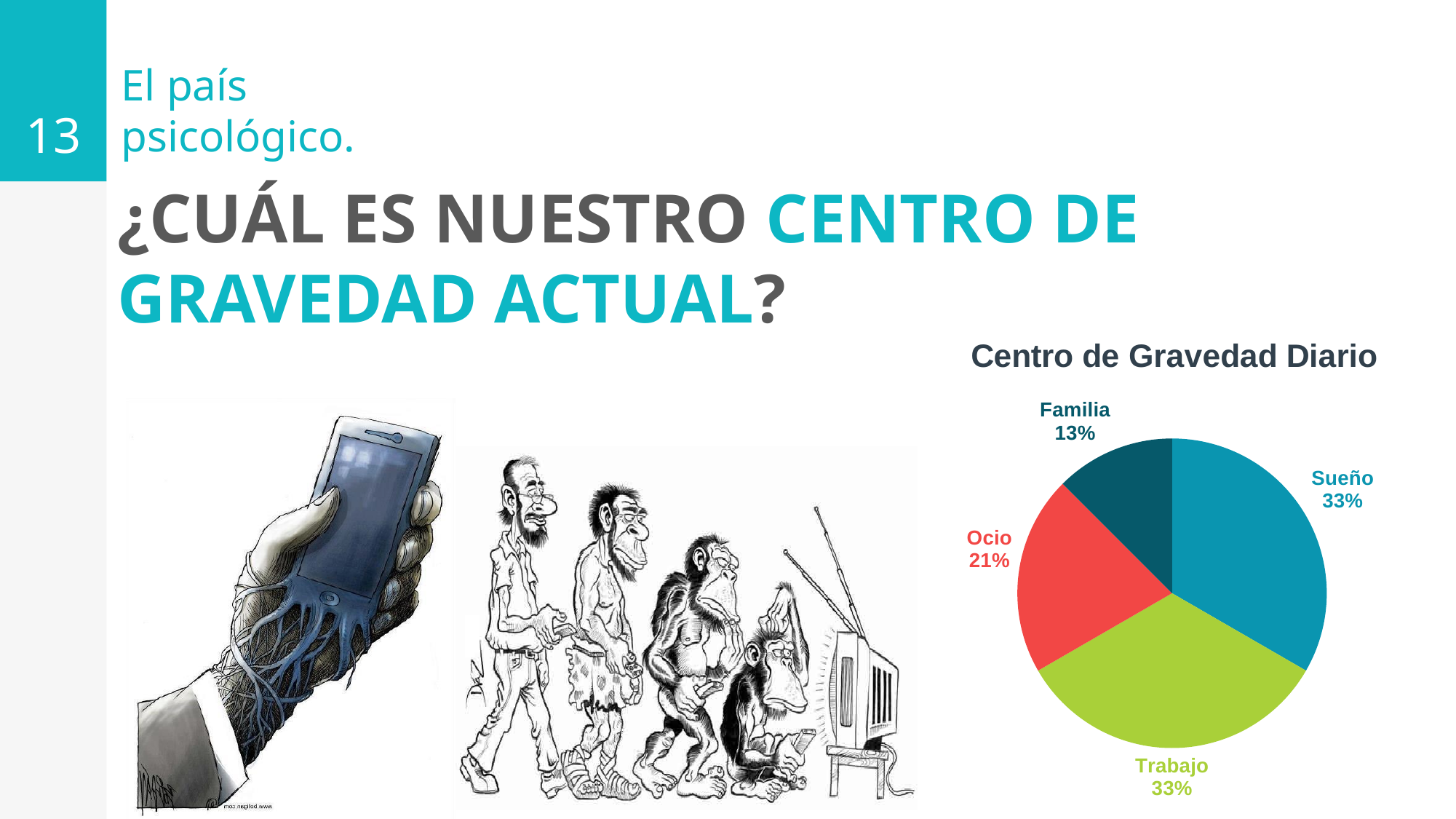
How many categories are shown in the pie chart? 4 What percentage does the Familia slice represent? 13% What percentage does the Trabajo slice represent? 33% What percentage does the Sueño slice represent? 33% What is the difference in percentage points between Sueño and Familia? 20% What percentage does the Ocio slice represent? 21% Which category has the smallest slice of the pie? Familia Which is larger, the Ocio slice or the Familia slice? Ocio What colour is the Trabajo slice? green What kind of chart is shown on the slide? pie chart What is the title of the chart? Centro de Gravedad Diario What is the difference in percentage points between Ocio and Familia? 8%